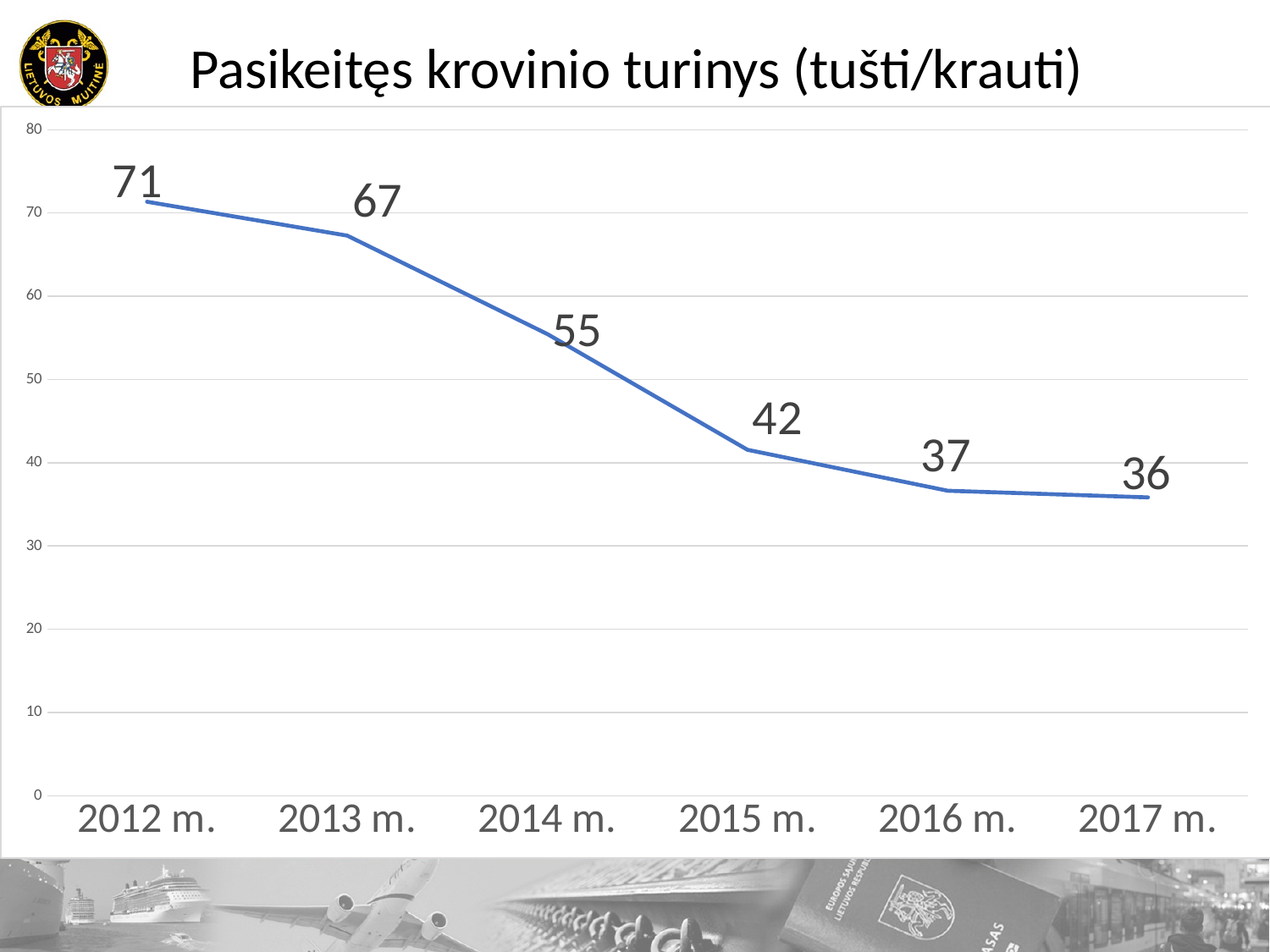
What is the difference between the values for 2013 m. and 2014 m.? 12 What is the value for 2017 m.? 36 Which year has the lowest value? 2017 m. Which is larger, the value for 2014 m. or the value for 2016 m.? 2014 m. How many years are plotted on the chart? 6 Do the values rise or fall from 2012 m. to 2017 m.? fall What is the value for 2015 m.? 42 Is the value for 2015 m. greater or less than 50? less What kind of chart is shown on the slide? line chart What is the difference between the values for 2012 m. and 2017 m.? 35 What is the value for 2012 m.? 71 Which year has the highest value? 2012 m.